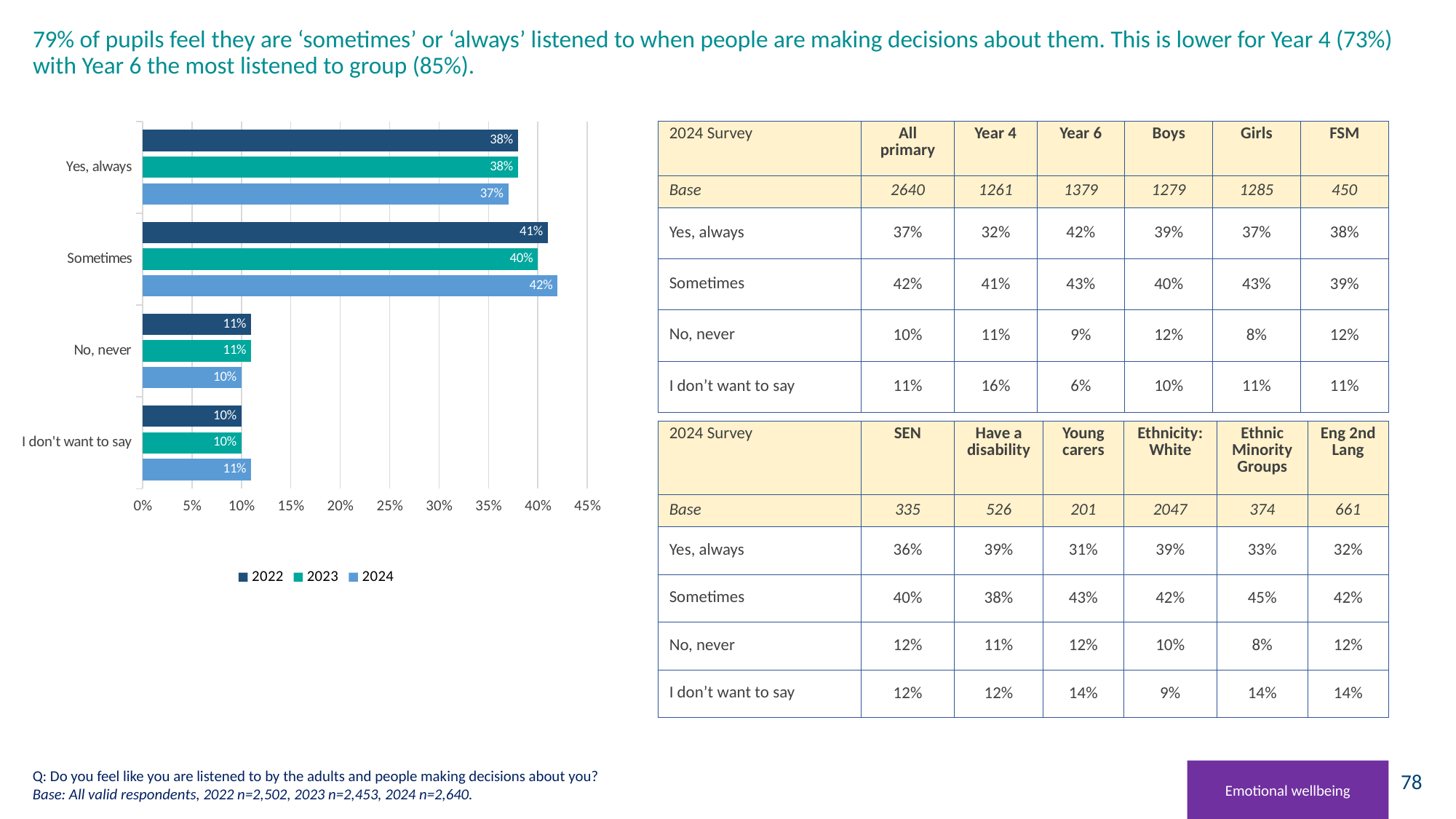
Which category has the lowest 2022 value in the bar chart? I don't want to say What is the 2023 value for 'No, never' in the bar chart? 11% How many series does the legend of the bar chart list? 3 How many categories are shown on the y axis of the bar chart? 4 What are the series names listed in the legend of the bar chart? 2022, 2023, 2024 What is the difference between the 2024 values for 'Sometimes' and 'Yes, always' in the bar chart? 5% What kind of chart is shown on the slide? bar chart In the bar chart, is the 2022 value for 'Sometimes' larger or smaller than the 2023 value for 'Sometimes'? larger What is the 2022 value for 'Yes, always' in the bar chart? 38% Which category has the highest 2024 value in the bar chart? Sometimes What is the 2024 value for 'Sometimes' in the bar chart? 42% What is the 2024 value for 'I don't want to say' in the bar chart? 11%